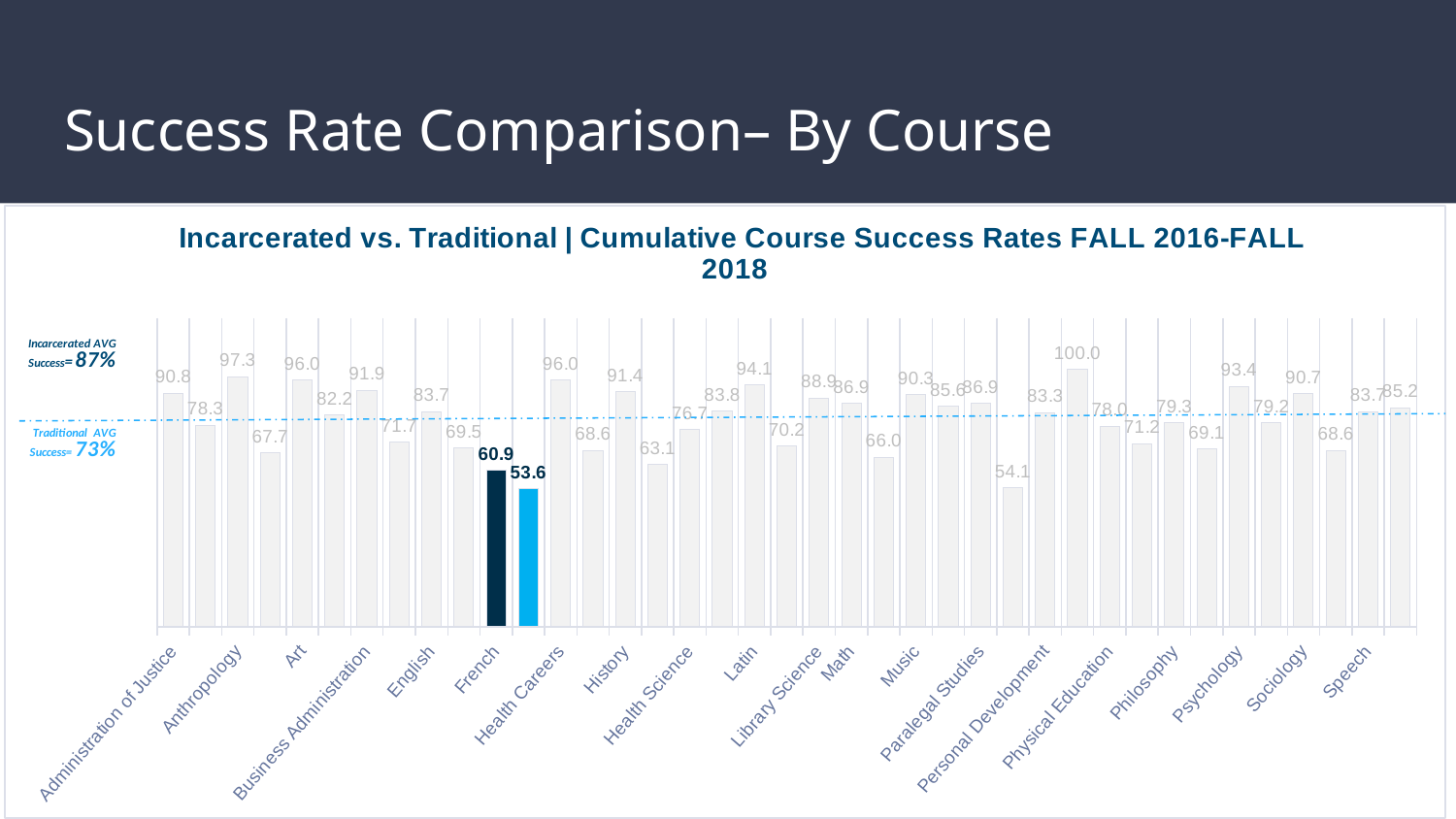
What is the title of the chart? Incarcerated vs. Traditional | Cumulative Course Success Rates FALL 2016-FALL 2018 What type of chart is shown on the slide? Bar chart How many courses are shown along the x axis of the chart? 20 Which course is highlighted in colour (dark navy and light blue) while all other bars are grey? French What is the highest value labelled on any bar in the chart? 100.0 What is the lowest value labelled on any bar in the chart? 53.6 According to the annotation on the left of the chart, what is the Incarcerated average success rate? 87% What is the difference between the two French bars (60.9 and 53.6)? 7.3 What is the value of the dark navy highlighted bar for French? 60.9 What is the value of the light blue highlighted bar for French? 53.6 Which course has the bar with the highest value (100.0)? Personal Development Which of the two French bars is larger, the dark navy one or the light blue one? The dark navy one (60.9)